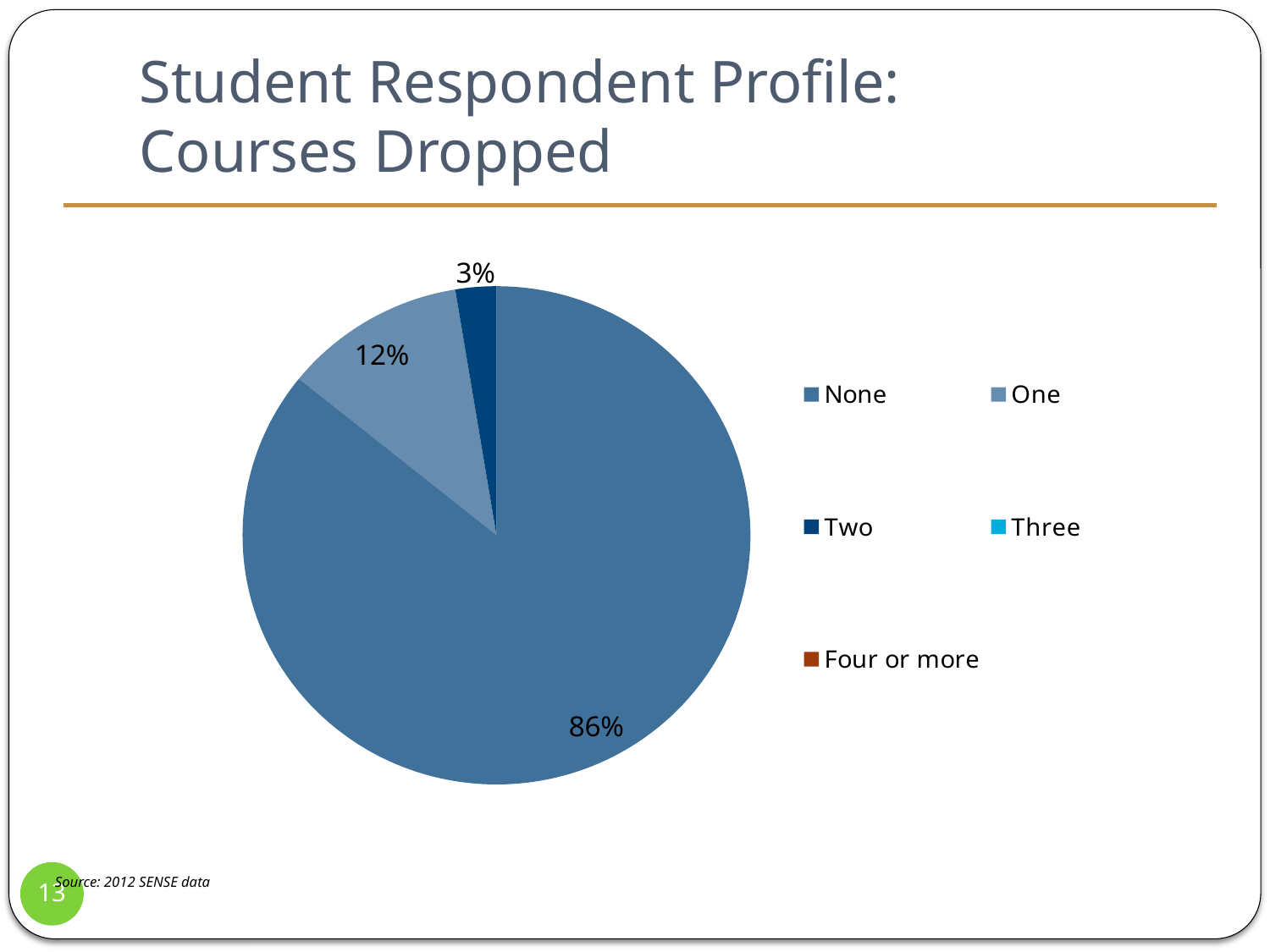
How many categories does the legend list? 5 What share of respondents dropped no courses (None)? 86% Which of the labelled slices is the smallest? Two What is the title of the slide containing the chart? Student Respondent Profile: Courses Dropped What data source is cited for the chart? 2012 SENSE data What kind of chart is shown on the slide? pie chart What share of respondents dropped one course? 12% What share of respondents dropped two courses? 3% What is the difference in percentage points between the None slice and the One slice? 74 What is the difference in percentage points between the One slice and the Two slice? 9 Which category has the largest slice of the pie? None Which is larger, the share for One or the share for Two? One